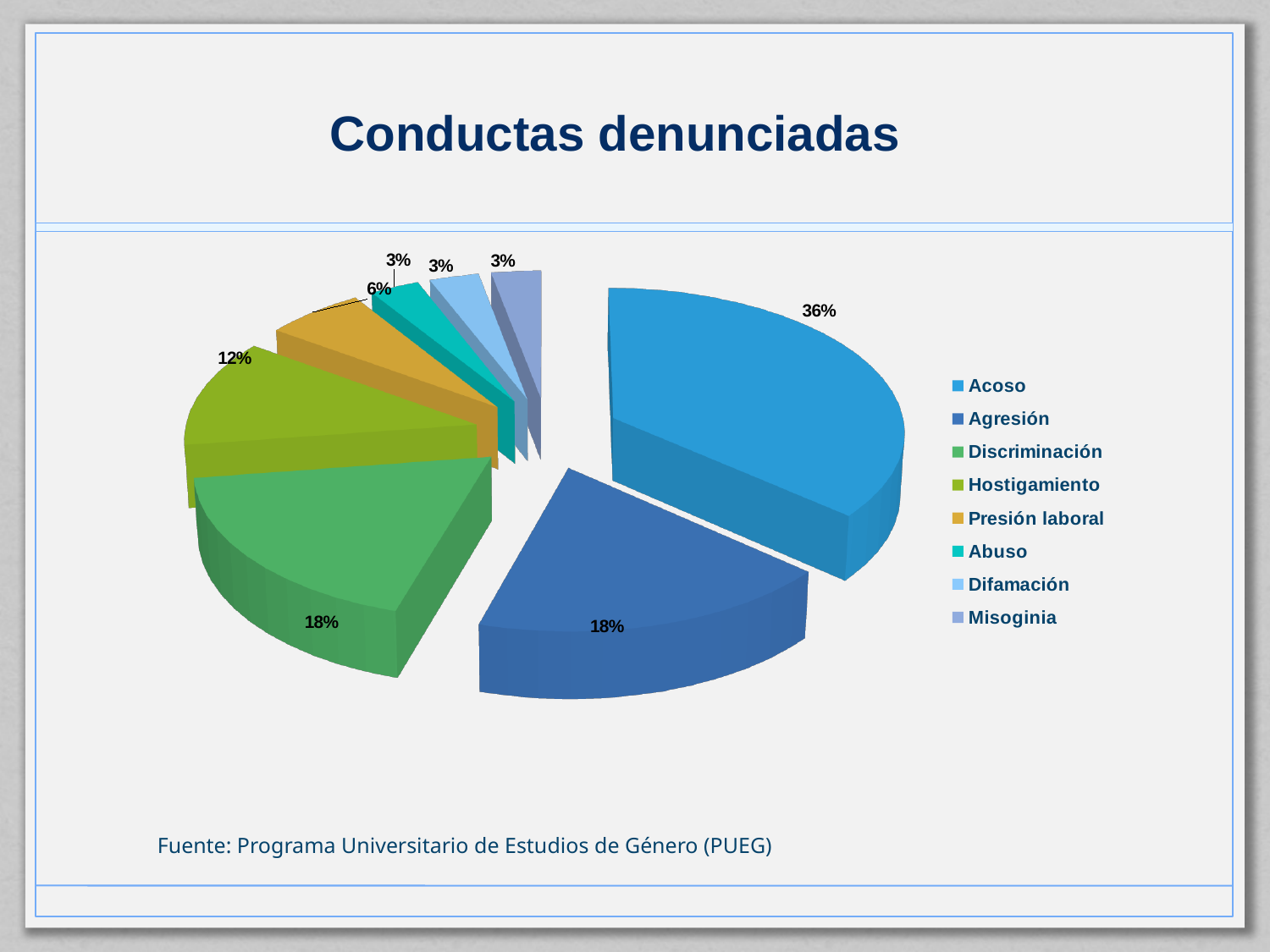
What is the title of the chart? Conductas denunciadas What is the difference in percentage points between Acoso and Hostigamiento? 24 What share of the pie does Acoso represent? 36% What percentage is shown for Hostigamiento? 12% What percentage is shown for Agresión? 18% What type of chart is shown on the slide? Pie chart Which is larger, the share for Hostigamiento or the share for Presión laboral? Hostigamiento What is the source cited below the chart? Programa Universitario de Estudios de Género (PUEG) How many categories does the legend list? 8 What is the smallest percentage shown on the pie chart? 3% What percentage is shown for Presión laboral? 6% Which category has the largest share of the pie? Acoso